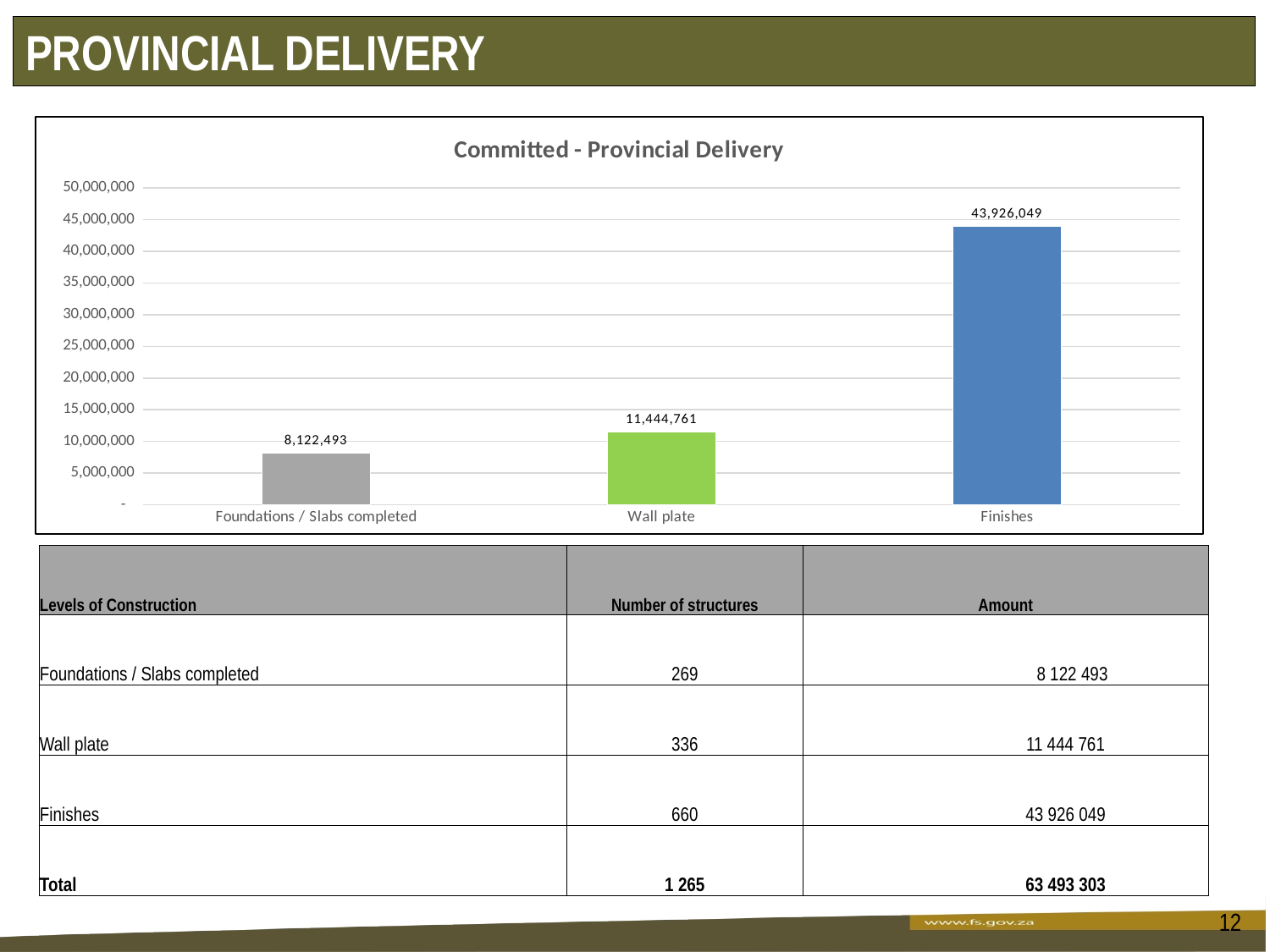
What is the value for Finishes in the Committed - Provincial Delivery chart? 43,926,049 What is the difference between the values for Wall plate and Foundations / Slabs completed in the Committed - Provincial Delivery chart? 3,322,268 Which category has the highest value in the Committed - Provincial Delivery chart? Finishes What kind of chart is the Committed - Provincial Delivery chart? bar chart Which is larger in the Committed - Provincial Delivery chart, Wall plate or Foundations / Slabs completed? Wall plate Is the value for Finishes in the Committed - Provincial Delivery chart greater or less than 40,000,000? greater What is the value for Wall plate in the Committed - Provincial Delivery chart? 11,444,761 Which category has the lowest value in the Committed - Provincial Delivery chart? Foundations / Slabs completed What is the difference between the values for Finishes and Wall plate in the Committed - Provincial Delivery chart? 32,481,288 What is the value for Foundations / Slabs completed in the Committed - Provincial Delivery chart? 8,122,493 How many categories are shown in the Committed - Provincial Delivery chart? 3 Do the values in the Committed - Provincial Delivery chart rise or fall from left to right along the x axis? rise